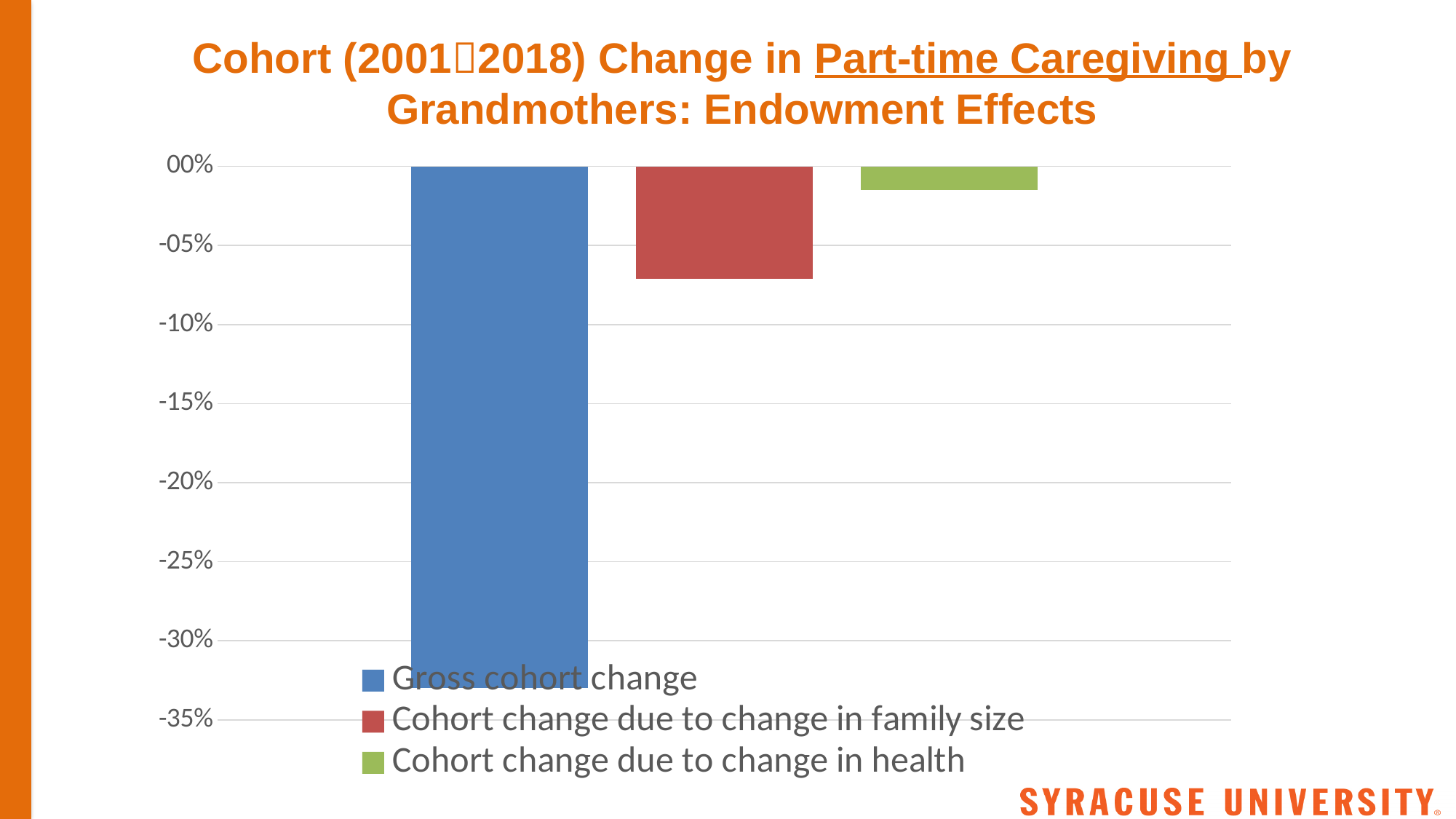
Is the value for Cohort change due to change in family size greater or less than -05%? less Which bar is longer: Cohort change due to change in family size or Cohort change due to change in health? Cohort change due to change in family size How many series does the legend list? 3 What kind of chart is shown on the slide? bar chart Is the value for Cohort change due to change in health greater or less than -05%? greater How many bars are plotted in the chart? 3 Is the value for Gross cohort change greater or less than -30%? less What is the title of the chart? Cohort (2001–2018) Change in Part-time Caregiving by Grandmothers: Endowment Effects Which series has the largest negative change (the longest bar)? Gross cohort change Which series has the smallest change in magnitude (the shortest bar)? Cohort change due to change in health What colour is the bar for Cohort change due to change in health? green